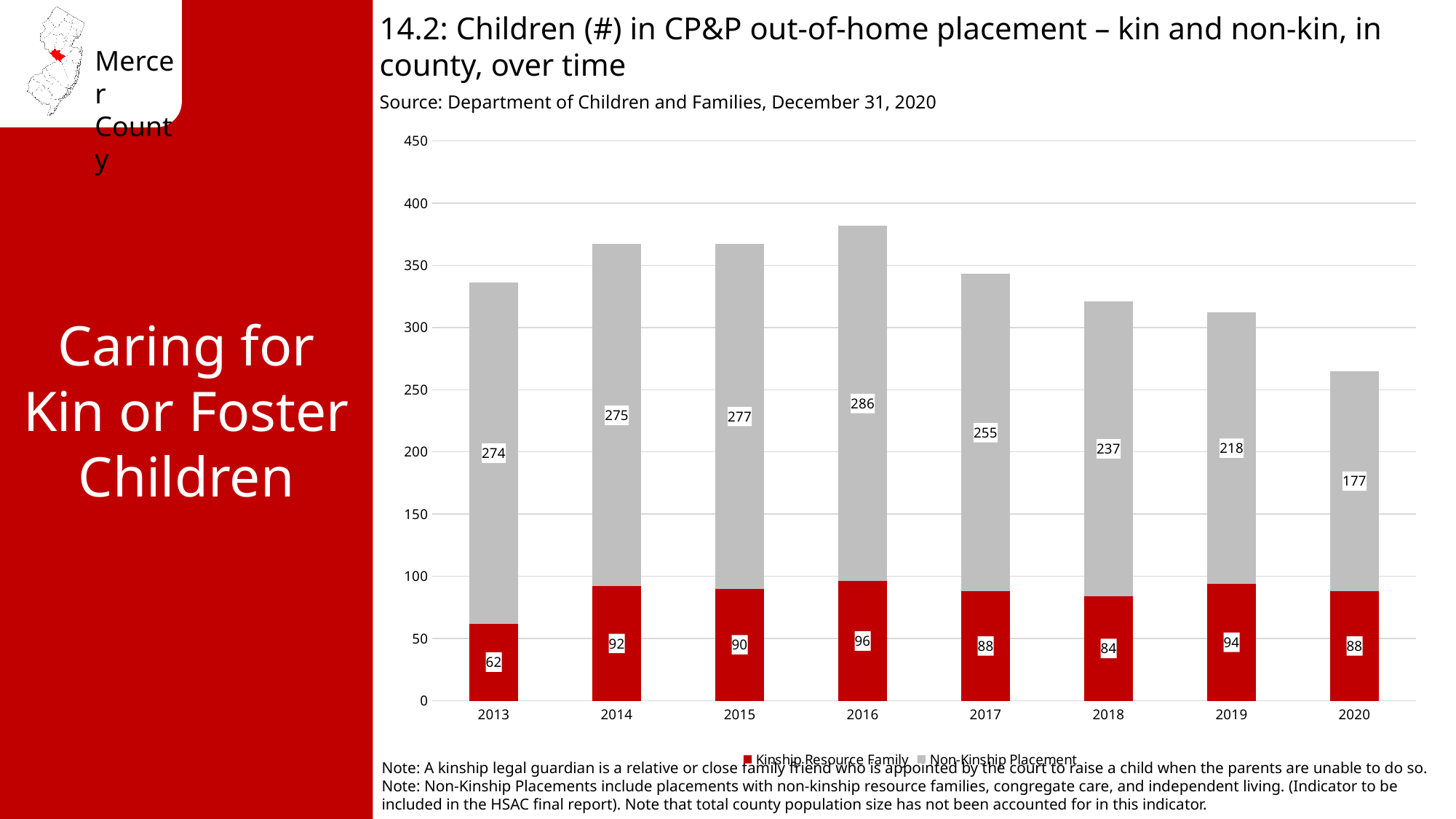
Which year has the highest Non-Kinship Placement value? 2016 Which year has the lowest Kinship Resource Family value? 2013 What is the value for Non-Kinship Placement in 2013? 274 How many series does the legend list? 2 What is the value for Kinship Resource Family in 2016? 96 What is the value for Non-Kinship Placement in 2020? 177 What kind of chart is shown on the slide? Stacked bar chart What is the difference between the Non-Kinship Placement values in 2016 and 2020? 109 What is the total of the stacked bar for 2016? 382 What is the total of the stacked bar for 2020? 265 Which is larger, the Kinship Resource Family value in 2019 or in 2018? 2019 How many years are shown on the x axis? 8